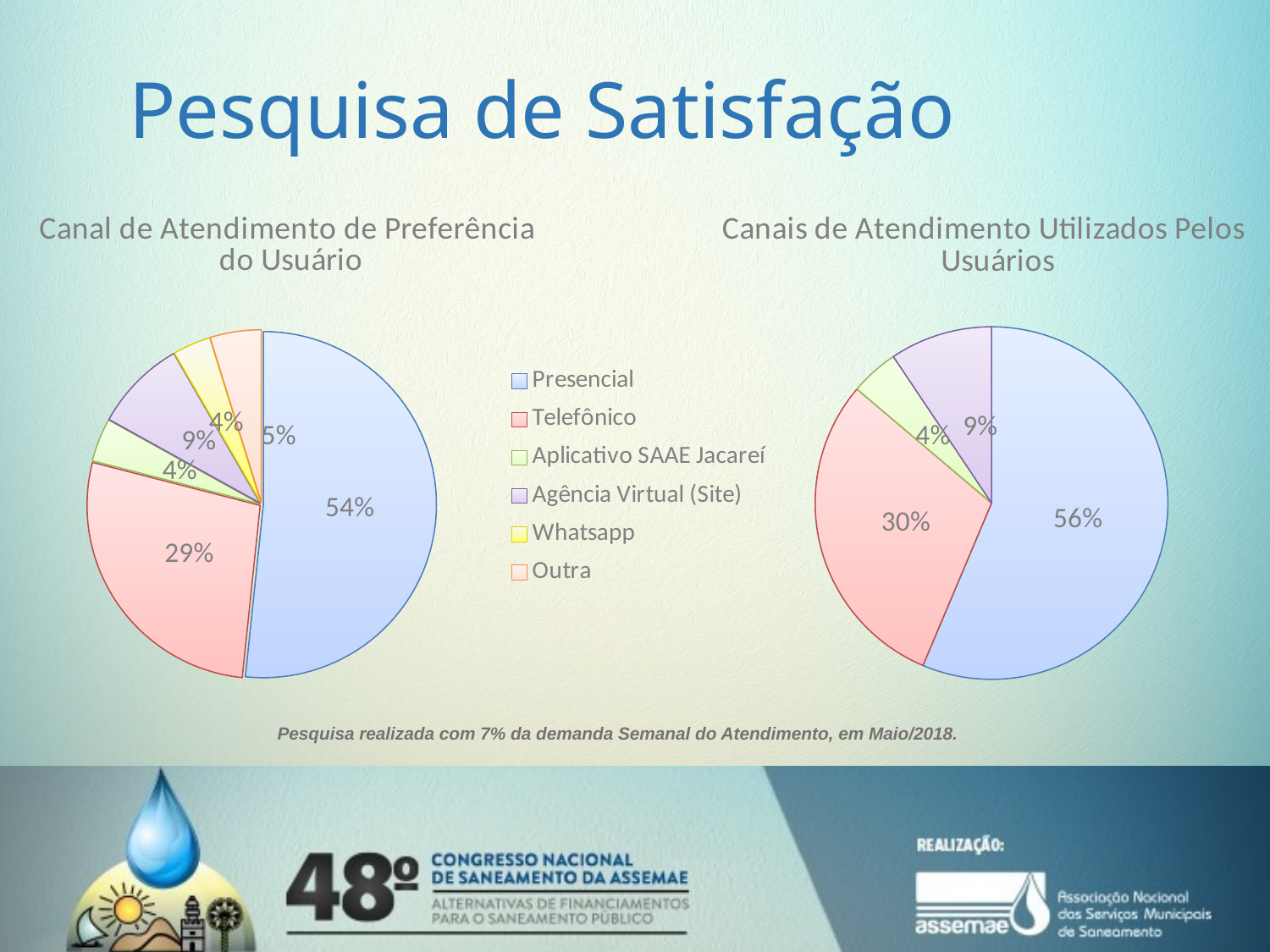
In the chart 'Canais de Atendimento Utilizados Pelos Usuários', what share does Presencial have? 56% In the chart 'Canal de Atendimento de Preferência do Usuário', what share does Agência Virtual (Site) have? 9% In the chart 'Canais de Atendimento Utilizados Pelos Usuários', which is larger, Telefônico or Agência Virtual (Site)? Telefônico In the chart 'Canal de Atendimento de Preferência do Usuário', which channel has the largest share? Presencial In the chart 'Canal de Atendimento de Preferência do Usuário', what share does Presencial have? 54% In the chart 'Canais de Atendimento Utilizados Pelos Usuários', which channel has the largest share? Presencial In the chart 'Canais de Atendimento Utilizados Pelos Usuários', what share does Telefônico have? 30% What type of chart is 'Canais de Atendimento Utilizados Pelos Usuários'? Pie chart In the chart 'Canais de Atendimento Utilizados Pelos Usuários', what share does Aplicativo SAAE Jacareí have? 4% In the chart 'Canal de Atendimento de Preferência do Usuário', what share does Telefônico have? 29% In the chart 'Canal de Atendimento de Preferência do Usuário', what is the difference between the Presencial and Telefônico shares? 25% How many entries does the legend between the two charts list? 6